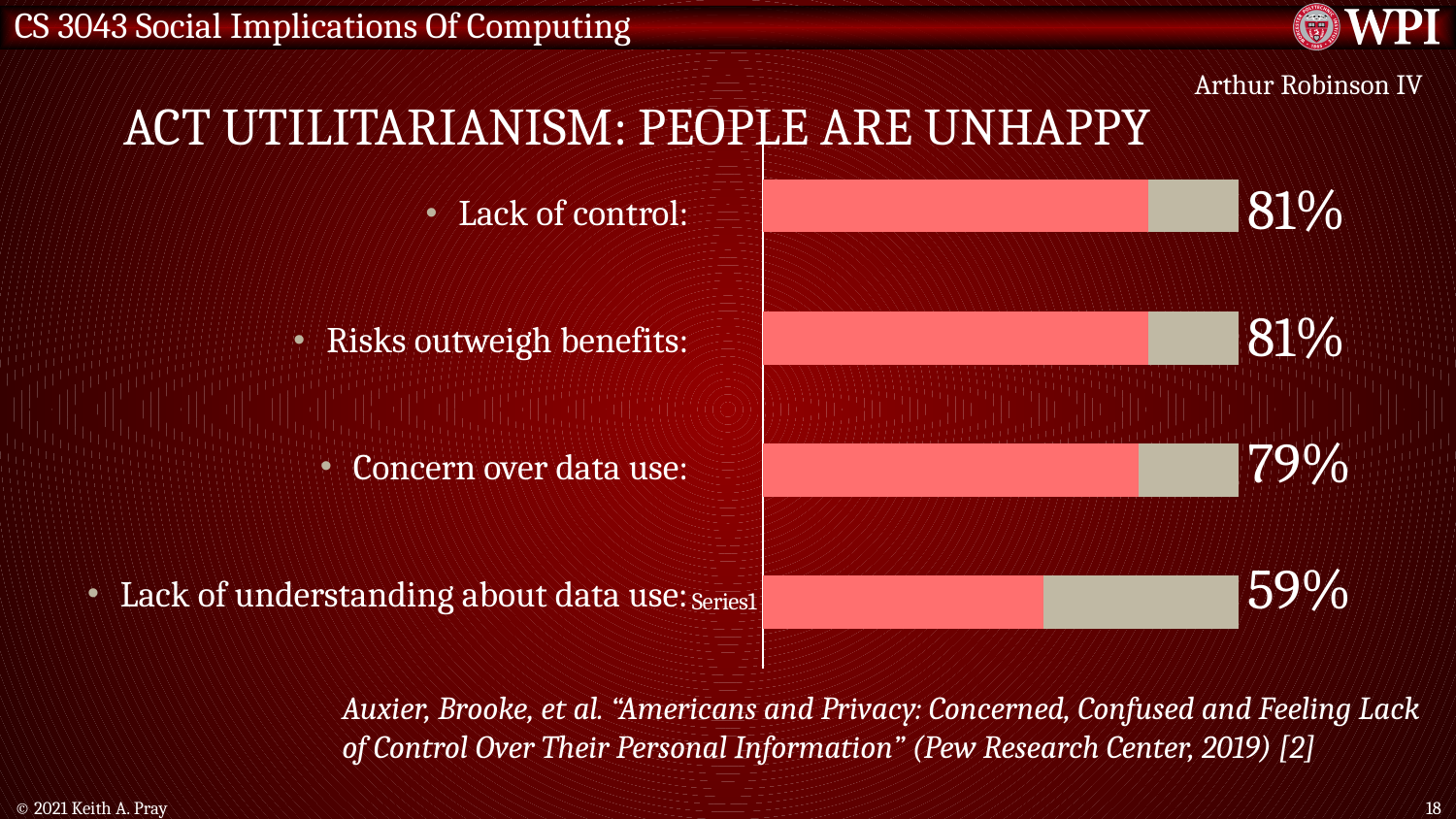
What percentage is shown for "Lack of understanding about data use"? 59% What is the difference between the percentage for "Lack of control" and the percentage for "Lack of understanding about data use"? 22% Which is larger, the percentage for "Concern over data use" or the percentage for "Lack of understanding about data use"? Concern over data use What is the title of the slide containing the chart? Act Utilitarianism: People Are Unhappy What percentage is shown for "Concern over data use"? 79% Which category has the lowest percentage? Lack of understanding about data use What kind of chart is shown on the slide? Bar chart What colour is the larger (left) portion of each bar? Pink What percentage is shown for "Risks outweigh benefits"? 81% What percentage is shown for "Lack of control"? 81% How many bars are shown in the chart? 4 What is the difference between the percentage for "Risks outweigh benefits" and the percentage for "Concern over data use"? 2%